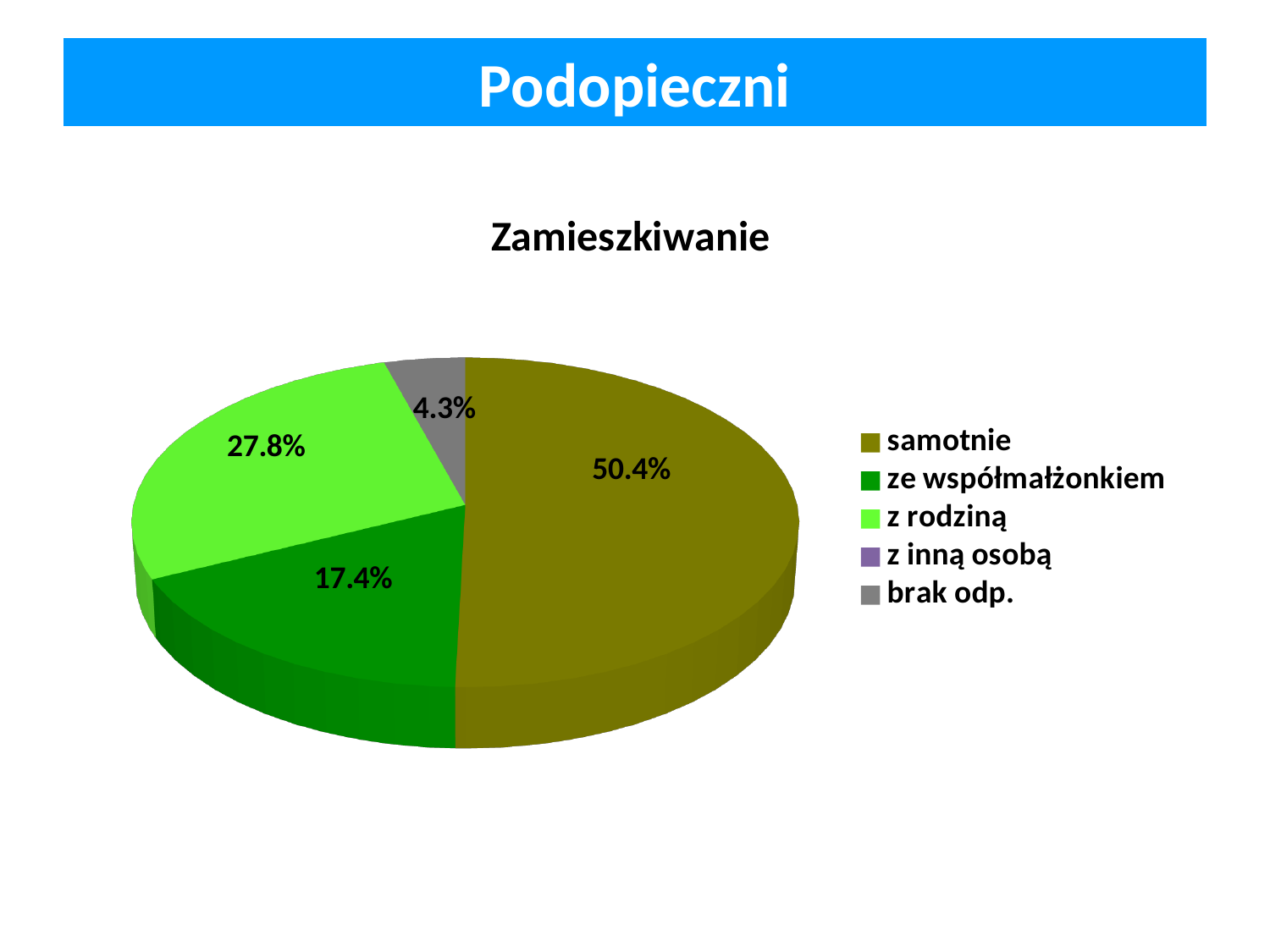
Which is larger, the share for 'z rodziną' or for 'ze współmałżonkiem'? z rodziną What percentage is shown for 'brak odp.'? 4.3% What percentage is shown for 'ze współmałżonkiem'? 17.4% What percentage is shown for 'z rodziną'? 27.8% Which category has the largest share of the pie? samotnie How many entries does the legend list? 5 What is the difference in percentage points between 'z rodziną' and 'ze współmałżonkiem'? 10.4 What type of chart is shown on the slide? pie chart Which labelled slice has the smallest share of the pie? brak odp. What percentage of the pie is labelled for 'samotnie'? 50.4% What colour is the 'samotnie' slice? olive green What is the title of the chart? Zamieszkiwanie